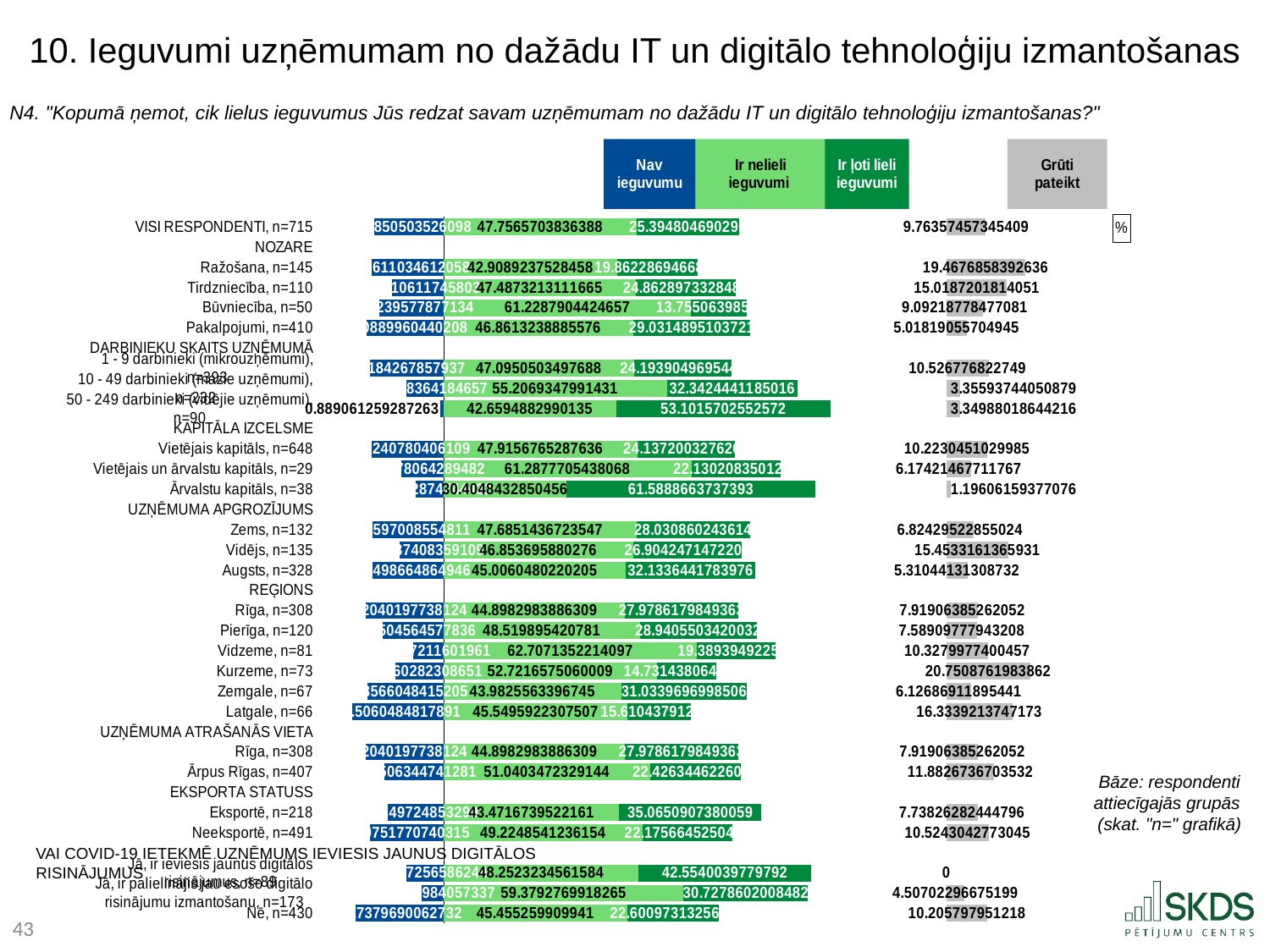
What is the value of "Ir ļoti lieli ieguvumi" for Ārvalstu kapitāls, n=38? 61.5888663737393 What is the value of "Grūti pateikt" for Kurzeme, n=73? 20.7508761983862 What is the value of "Grūti pateikt" for Vidzeme, n=81? 10.3279977400457 Which has the larger value for "Ir nelieli ieguvumi": Vidzeme, n=81 or Kurzeme, n=73? Vidzeme, n=81 What is the value of "Ir ļoti lieli ieguvumi" for Eksportē, n=218? 35.0650907380059 Which group has the highest value for "Ir ļoti lieli ieguvumi"? Ārvalstu kapitāls, n=38 What kind of chart is shown on the slide? bar chart What is the value of "Grūti pateikt" for "Jā, ir ieviesis jaunus digitālos risinājumus"? 0 Which group has the lowest value for "Grūti pateikt"? Jā, ir ieviesis jaunus digitālos risinājumus How many series does the legend list? 4 What is the value of "Ir nelieli ieguvumi" for Būvniecība, n=50? 61.2287904424657 What colour represents the "Nav ieguvumu" series in the legend? dark blue